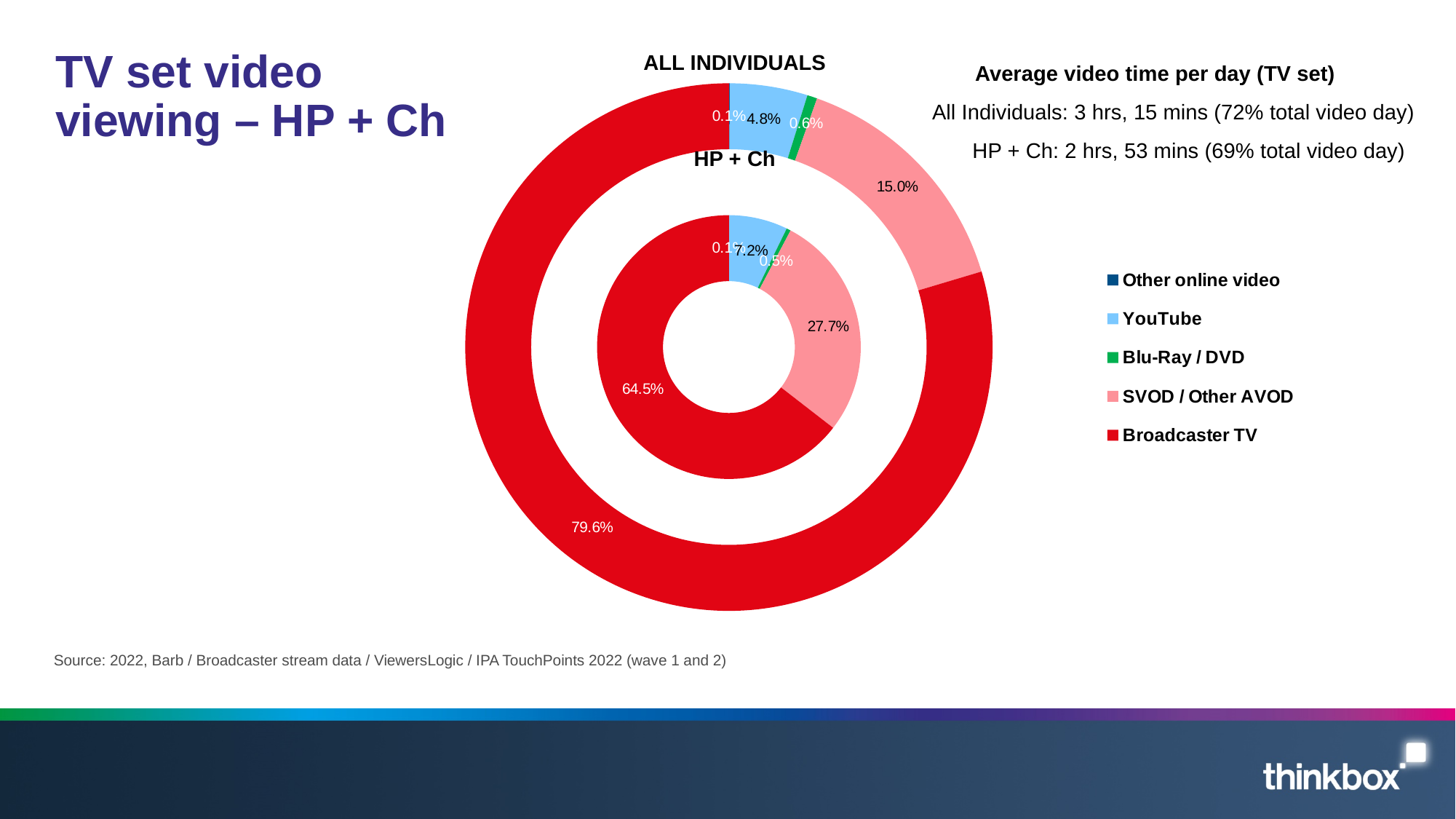
How many categories does the legend list? 5 How much higher is the Broadcaster TV share for All Individuals than for HP + Ch? 15.1 percentage points What type of chart is shown on the slide? Doughnut chart What is the difference between the SVOD / Other AVOD share for HP + Ch and for All Individuals? 12.7 percentage points What is the Blu-Ray / DVD share for All Individuals? 0.6% What share of TV set video viewing for HP + Ch is SVOD / Other AVOD? 27.7% Which category has the largest share in the HP + Ch ring? Broadcaster TV Which ring of the doughnut chart represents HP + Ch, the inner or the outer? Inner What is the YouTube share for HP + Ch? 7.2% Which category has the smallest share in the All Individuals ring? Other online video Which group has the larger YouTube share, All Individuals or HP + Ch? HP + Ch What share of TV set video viewing for All Individuals is Broadcaster TV? 79.6%